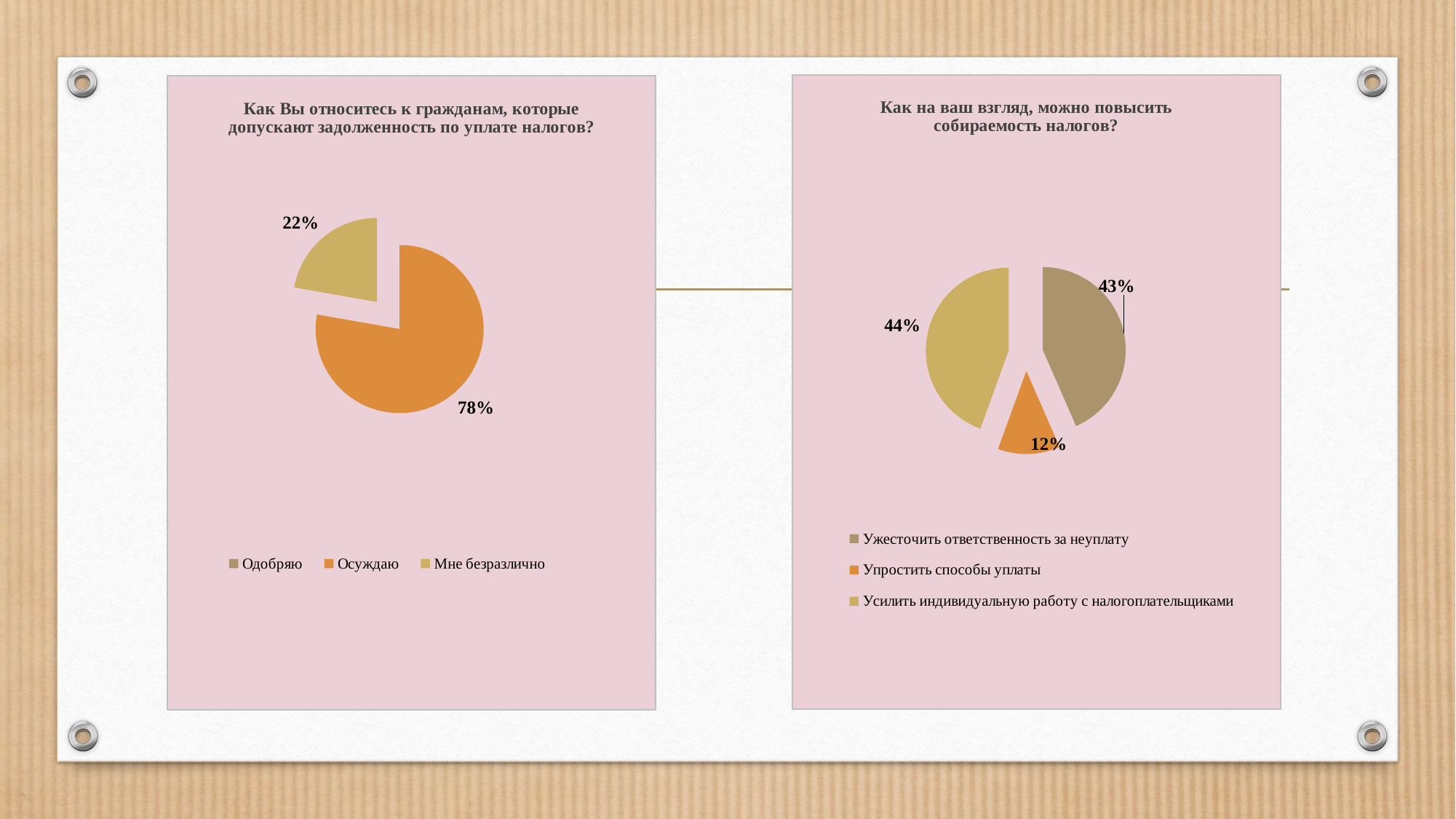
On the right chart, which is larger: the share for "Ужесточить ответственность за неуплату" or the share for "Упростить способы уплаты"? Ужесточить ответственность за неуплату On the left chart, how many entries does the legend list? 3 On the left chart, what share of respondents answered "Осуждаю"? 78% On the right chart, what colour is the slice for "Упростить способы уплаты"? Orange On the right chart, what share of respondents chose "Упростить способы уплаты"? 12% On the right chart, what share of respondents chose "Ужесточить ответственность за неуплату"? 43% What kind of chart is the left chart? Pie chart On the left chart, what is the difference between the shares for "Осуждаю" and "Мне безразлично"? 56% On the right chart, what share of respondents chose "Усилить индивидуальную работу с налогоплательщиками"? 44% On the left chart, which answer has the largest share? Осуждаю On the right chart, which answer has the smallest share? Упростить способы уплаты On the left chart, what share of respondents answered "Мне безразлично"? 22%